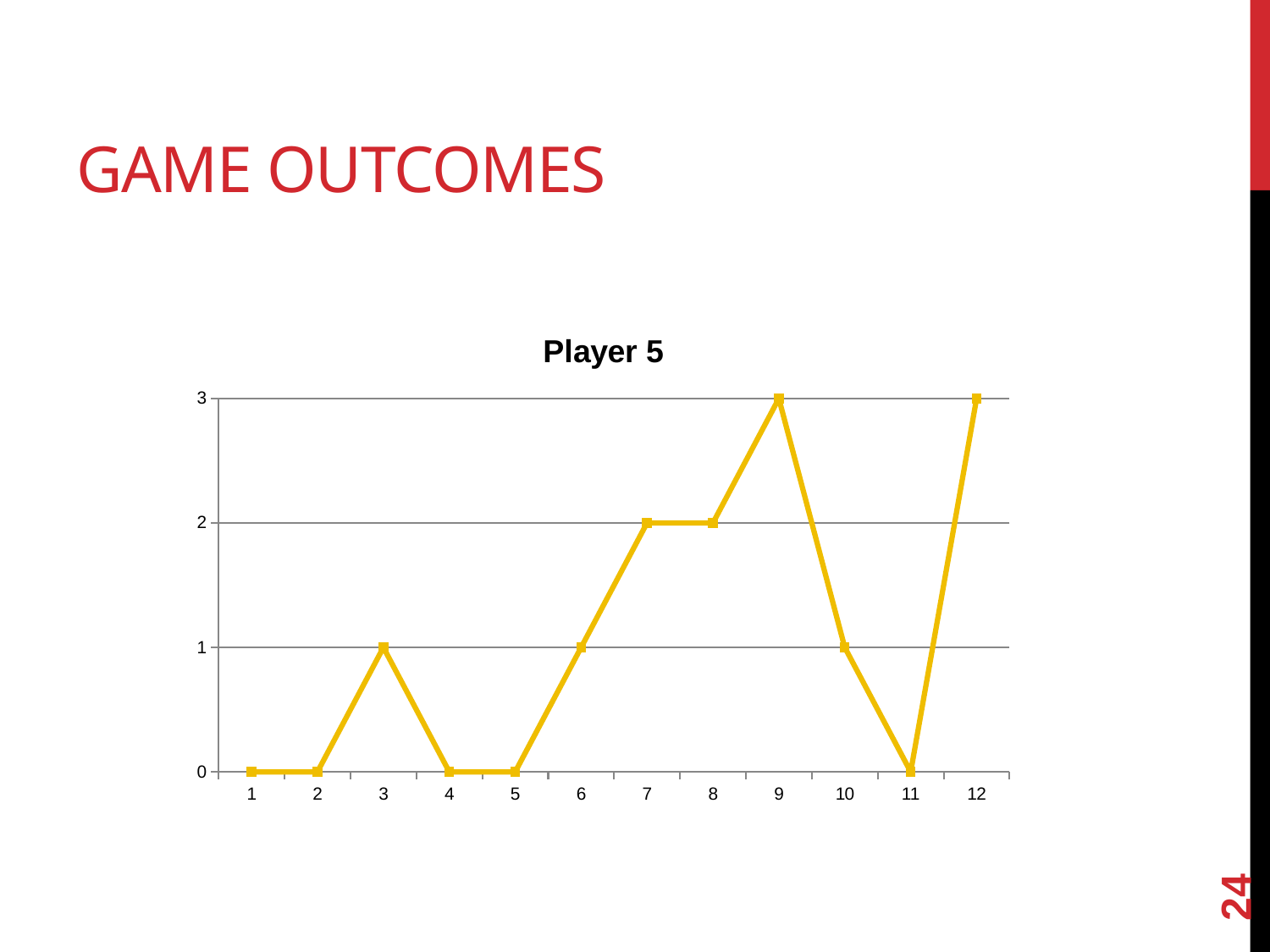
Is the value at x = 10 greater or less than 2? less What is the value at x = 9? 3 What is the difference between the values at x = 9 and x = 10? 2 What is the title of the chart? Player 5 Which has the larger value, x = 6 or x = 8? 8 What is the highest value reached on the chart? 3 How many points are plotted along the x axis? 12 What is the value at x = 3? 1 What is the value at x = 11? 0 What is the value at x = 7? 2 What kind of chart is shown on the slide? line chart Do the values rise or fall from x = 5 to x = 9? rise